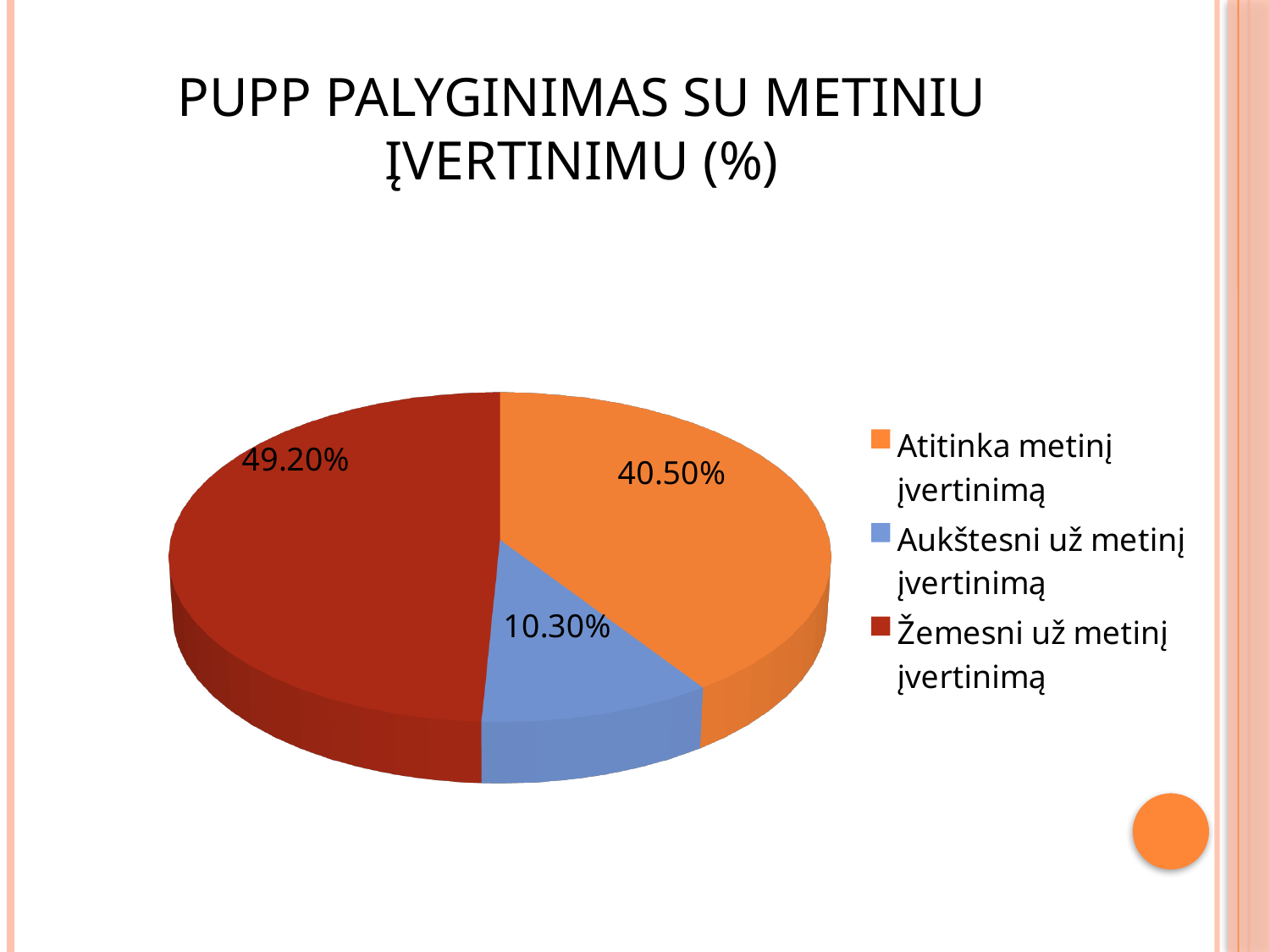
Which is larger: the share for "Atitinka metinį įvertinimą" or for "Aukštesni už metinį įvertinimą"? Atitinka metinį įvertinimą What type of chart is shown on the slide? pie chart Which category has the smallest share of the pie? Aukštesni už metinį įvertinimą What is the value for "Atitinka metinį įvertinimą"? 40.50% What is the value for "Žemesni už metinį įvertinimą"? 49.20% What is the difference between the values for "Žemesni už metinį įvertinimą" and "Atitinka metinį įvertinimą"? 8.70% How many slices does the pie chart have? 3 Which category has the largest share of the pie? Žemesni už metinį įvertinimą What is the title of the chart on the slide? PUPP PALYGINIMAS SU METINIU ĮVERTINIMU (%) What colour is the slice for "Aukštesni už metinį įvertinimą"? blue What is the value for "Aukštesni už metinį įvertinimą"? 10.30% What is the difference between the values for "Atitinka metinį įvertinimą" and "Aukštesni už metinį įvertinimą"? 30.20%